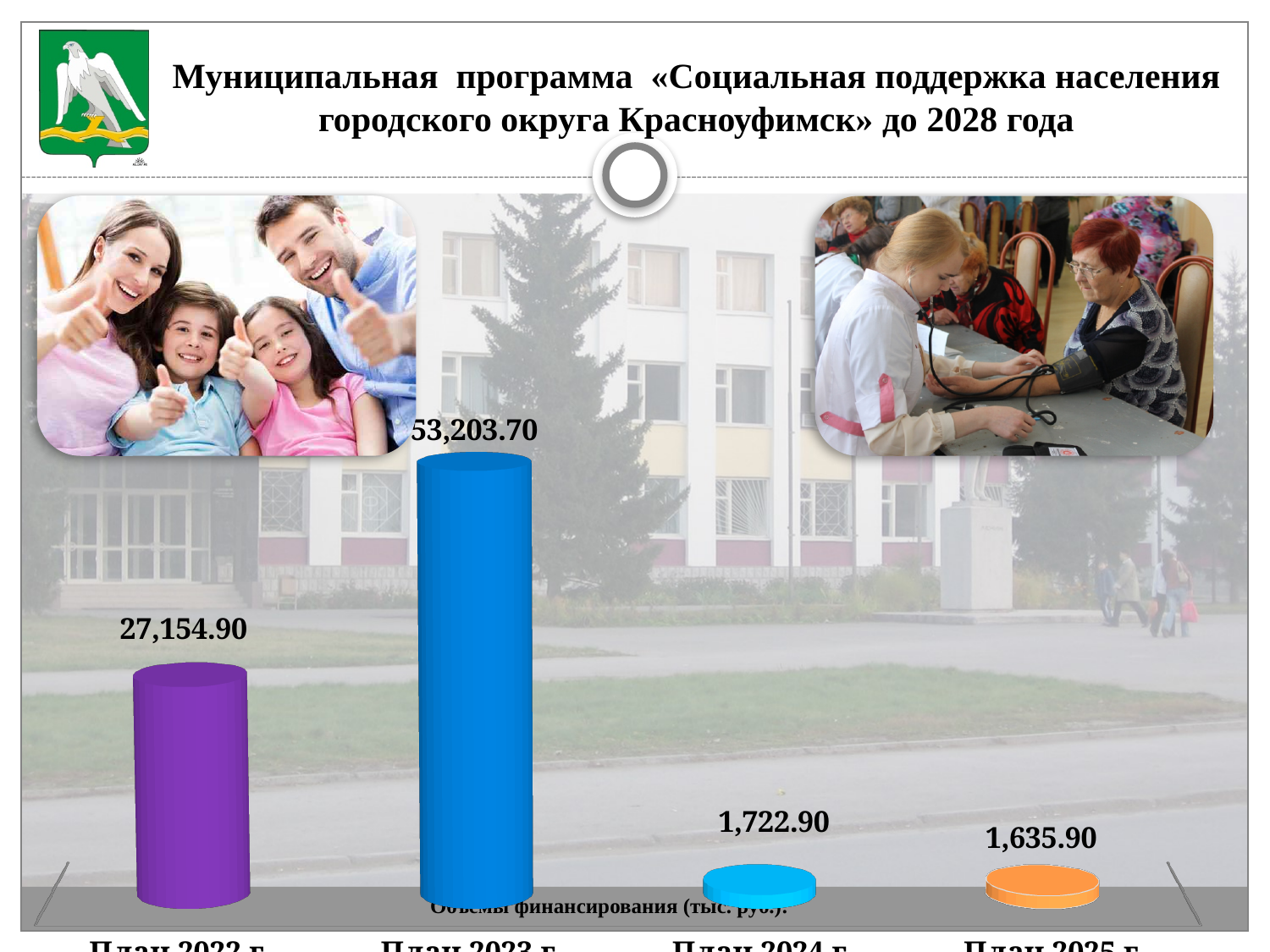
How many categories are shown in the chart? 4 What colour is the bar for План 2022 г.? Purple What is the difference between the values for План 2024 г. and План 2025 г.? 87.00 What is the value for План 2023 г.? 53,203.70 Which category has the highest value? План 2023 г. What is the difference between the values for План 2023 г. and План 2022 г.? 26,048.80 What is the value for План 2024 г.? 1,722.90 What is the value for План 2025 г.? 1,635.90 Which category has the lowest value? План 2025 г. What is the value for План 2022 г.? 27,154.90 Which is larger, the value for План 2022 г. or the value for План 2024 г.? План 2022 г. What kind of chart is shown on the slide? Bar chart